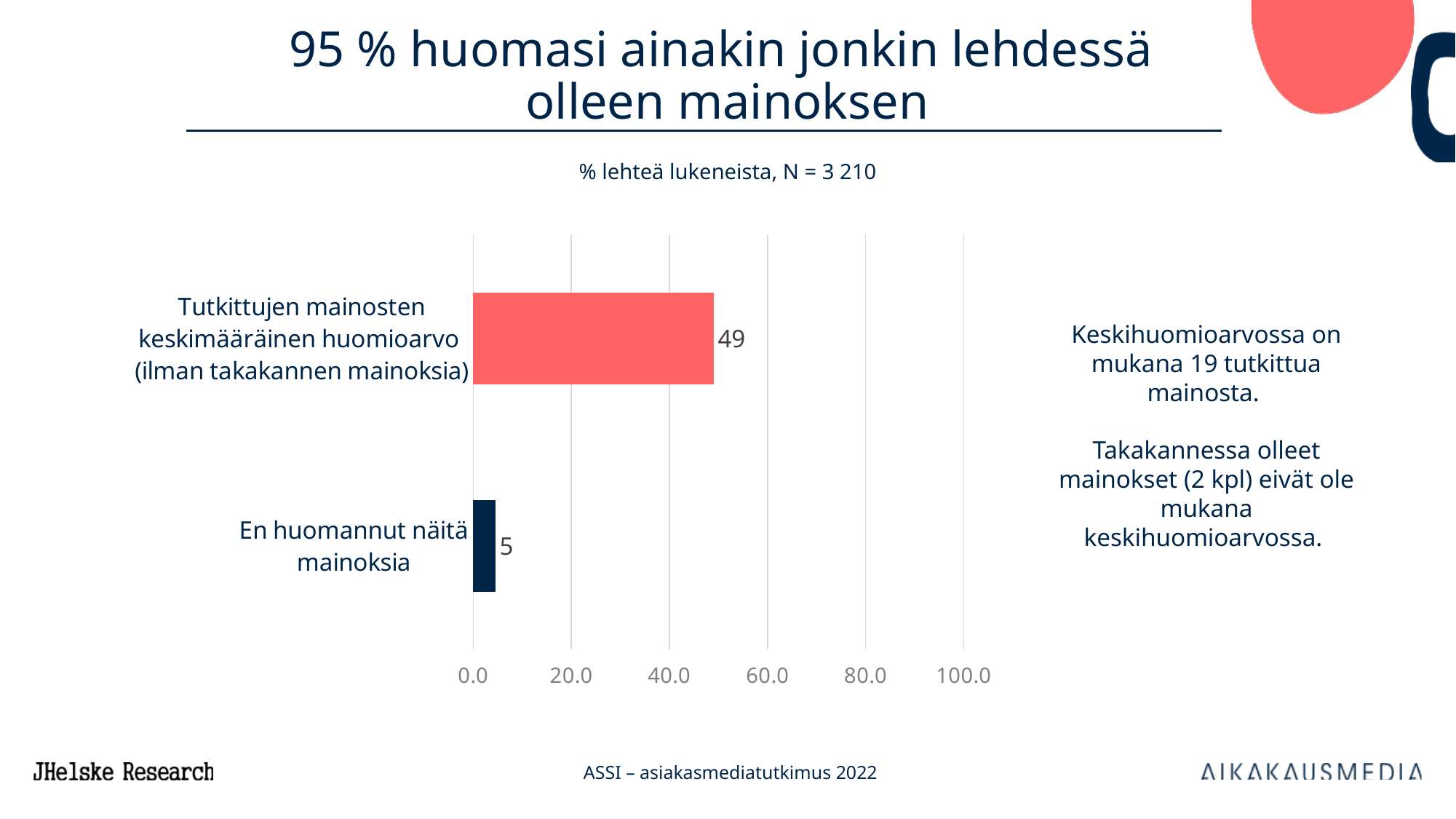
How many categories are shown in the chart? 2 What kind of chart is shown on the slide? Bar chart What is the maximum value shown on the x axis? 100.0 What is the value for "En huomannut näitä mainoksia"? 5 Which category has the highest value? Tutkittujen mainosten keskimääräinen huomioarvo (ilman takakannen mainoksia) Is the value for "Tutkittujen mainosten keskimääräinen huomioarvo" greater or less than 60.0? less What is the difference between the values for "Tutkittujen mainosten keskimääräinen huomioarvo" and "En huomannut näitä mainoksia"? 44 Which is larger: the value for "Tutkittujen mainosten keskimääräinen huomioarvo" or for "En huomannut näitä mainoksia"? Tutkittujen mainosten keskimääräinen huomioarvo Is the value for "En huomannut näitä mainoksia" greater or less than 20.0? less Which category has the lowest value? En huomannut näitä mainoksia What is the sample size (N) stated in the chart subtitle? 3 210 What is the value for "Tutkittujen mainosten keskimääräinen huomioarvo (ilman takakannen mainoksia)"? 49